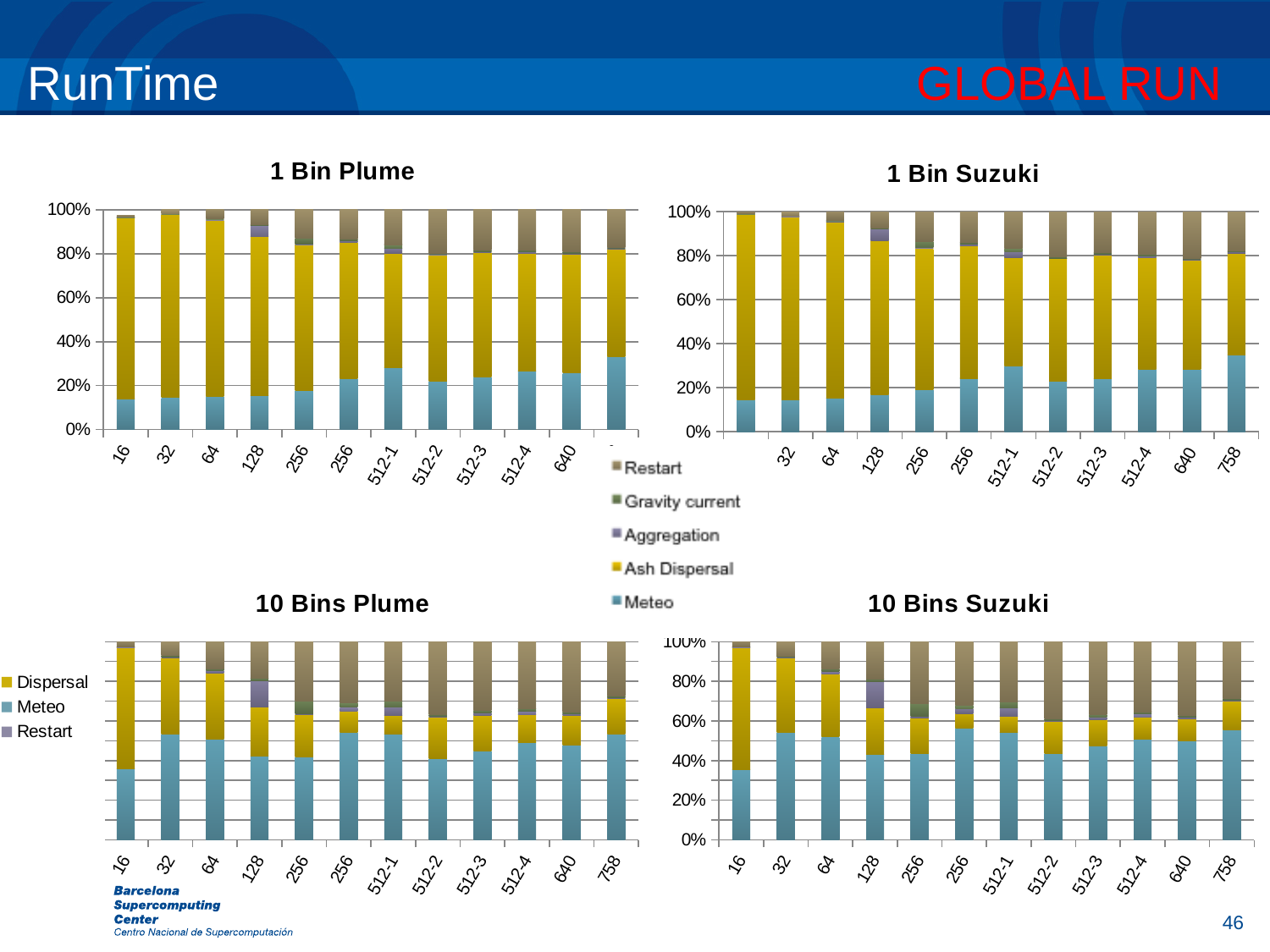
In the "1 Bin Plume" chart, is the Meteo share for 16 greater or less than 20%? less What kind of chart is the "1 Bin Plume" chart? stacked bar chart How many series does the central legend (Restart, Gravity current, ...) list? 5 In the "10 Bins Plume" chart, which category has the smallest Meteo share? 16 What is the title of the top-right chart? 1 Bin Suzuki In the "10 Bins Suzuki" chart, is the Meteo share for 512-1 greater or less than 40%? greater In the "1 Bin Plume" chart, is the Meteo share for 512-1 greater or less than 20%? greater In the "1 Bin Suzuki" chart, which has the larger Meteo share, 32 or 758? 758 How many bars does the "10 Bins Suzuki" chart have? 12 In the "1 Bin Plume" chart, does the Meteo share generally rise or fall from left to right along the x axis? rise How many charts are shown on the slide? 4